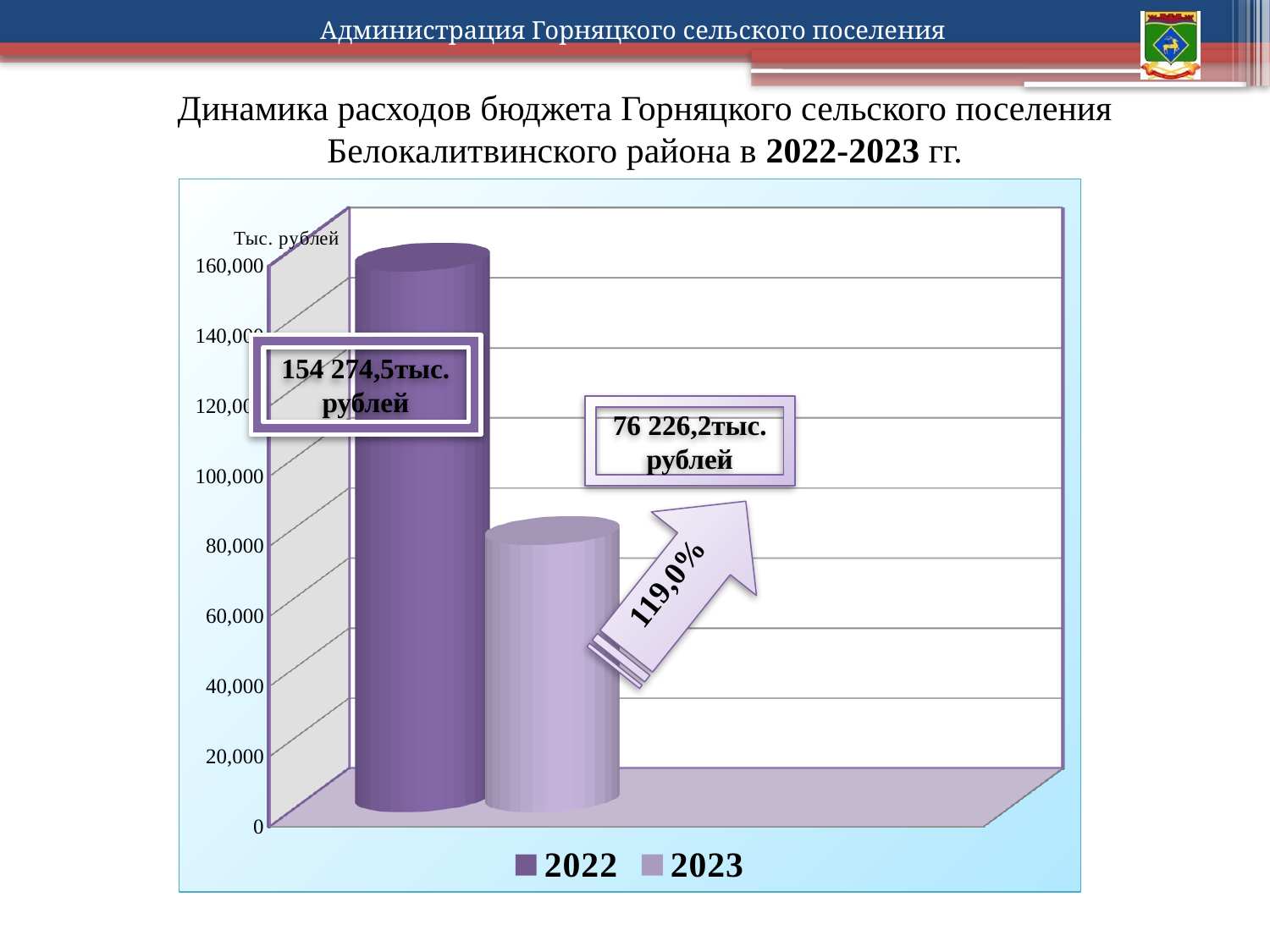
What is the difference between the 2022 value and the 2023 value? 78 048,3 тыс. рублей Which is larger, the value for 2022 or the value for 2023? 2022 What is the value shown for 2022? 154 274,5 тыс. рублей What unit is indicated on the vertical axis of the chart? Тыс. рублей Is the value for 2023 greater or less than 100,000? less Is the value for 2022 greater or less than 140,000? greater Which year has the highest expenditure value? 2022 How many series does the legend list? 2 Which year has the lowest expenditure value? 2023 What kind of chart is shown on the slide? Bar chart How many bars are plotted on the chart? 2 What is the value shown for 2023? 76 226,2 тыс. рублей